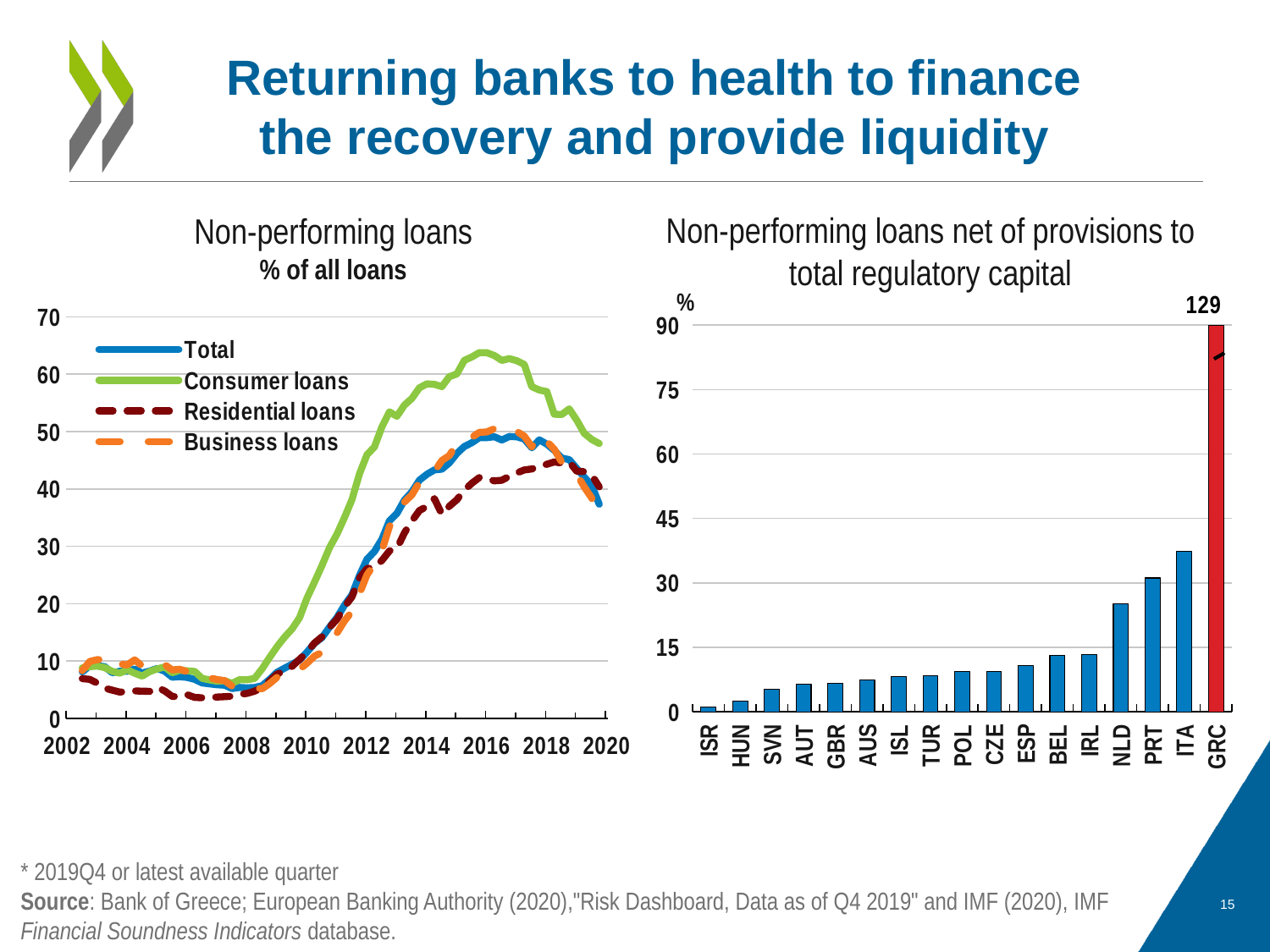
What kind of chart is the 'Non-performing loans net of provisions to total regulatory capital' chart? bar chart In the 'Non-performing loans net of provisions to total regulatory capital' chart, which country has the lowest value? ISR In the 'Non-performing loans net of provisions to total regulatory capital' chart, is the value for NLD greater or less than 30? less In the 'Non-performing loans net of provisions to total regulatory capital' chart, which country has the highest value? GRC In the 'Non-performing loans net of provisions to total regulatory capital' chart, is the value for ITA greater or less than 30? greater In the 'Non-performing loans net of provisions to total regulatory capital' chart, what is the value for GRC? 129 How many countries are shown in the 'Non-performing loans net of provisions to total regulatory capital' chart? 17 In the 'Non-performing loans net of provisions to total regulatory capital' chart, what colour is the bar for GRC? red How many series does the legend of the 'Non-performing loans' chart list? 4 What kind of chart is the 'Non-performing loans' chart? line chart In the 'Non-performing loans net of provisions to total regulatory capital' chart, which is larger, PRT or ITA? ITA In the 'Non-performing loans' chart, do the values for Total rise or fall between 2008 and 2016? rise